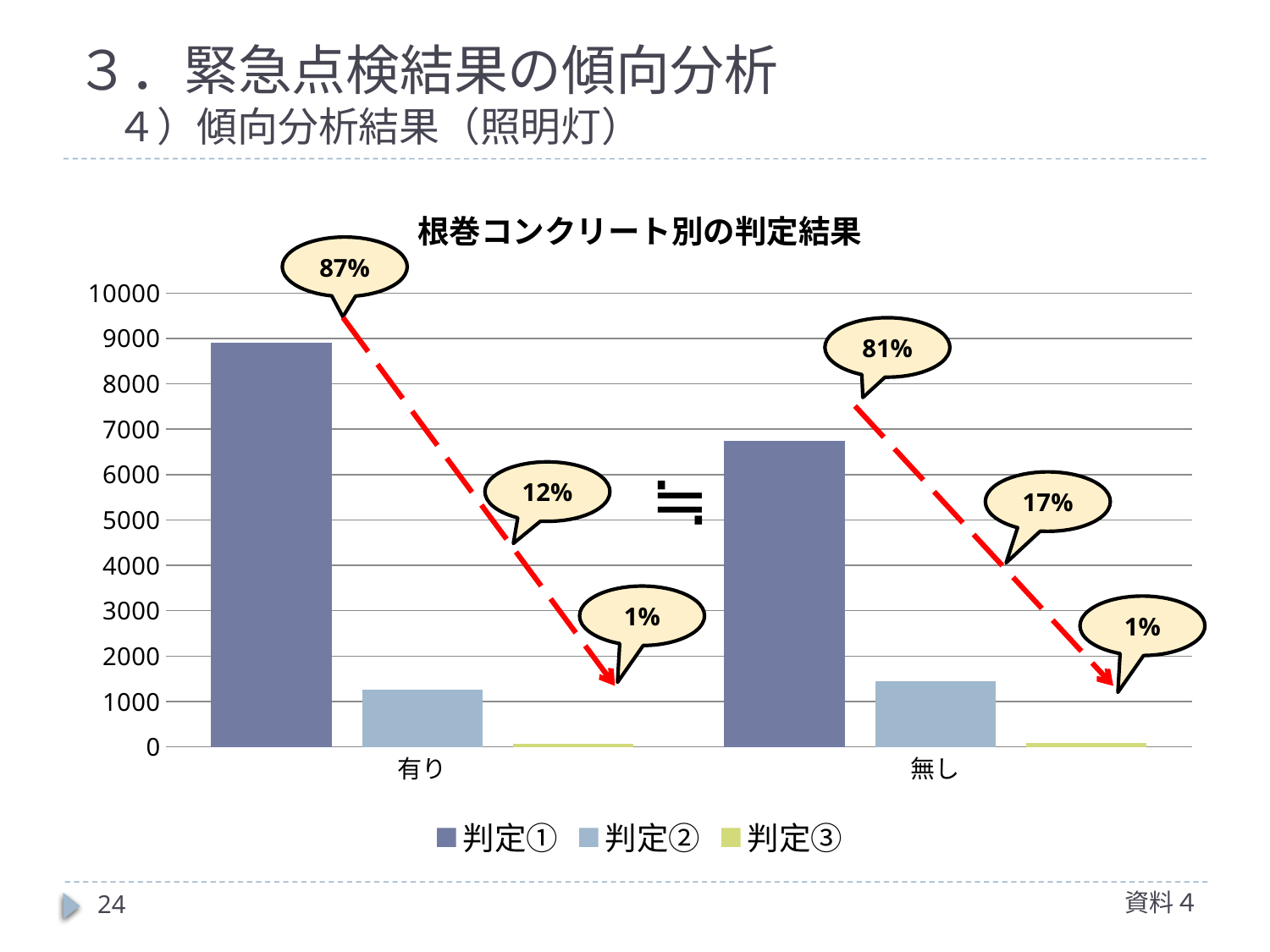
How many series does the legend list? 3 Is the 判定② bar for 有り greater or less than 1000? greater How many categories are shown on the x axis? 2 What kind of chart is shown on the slide? bar chart Is the 判定① bar for 有り greater or less than 8000? greater Is the 判定① bar for 無し greater or less than 6000? greater Which is larger, the 判定① bar for 有り or the 判定① bar for 無し? 有り What percentage is shown in the callout above the 判定① bar for 無し? 81% Which series has the shortest bar in the 無し category? 判定③ What is the title of the chart? 根巻コンクリート別の判定結果 Which series has the tallest bar in the 有り category? 判定①